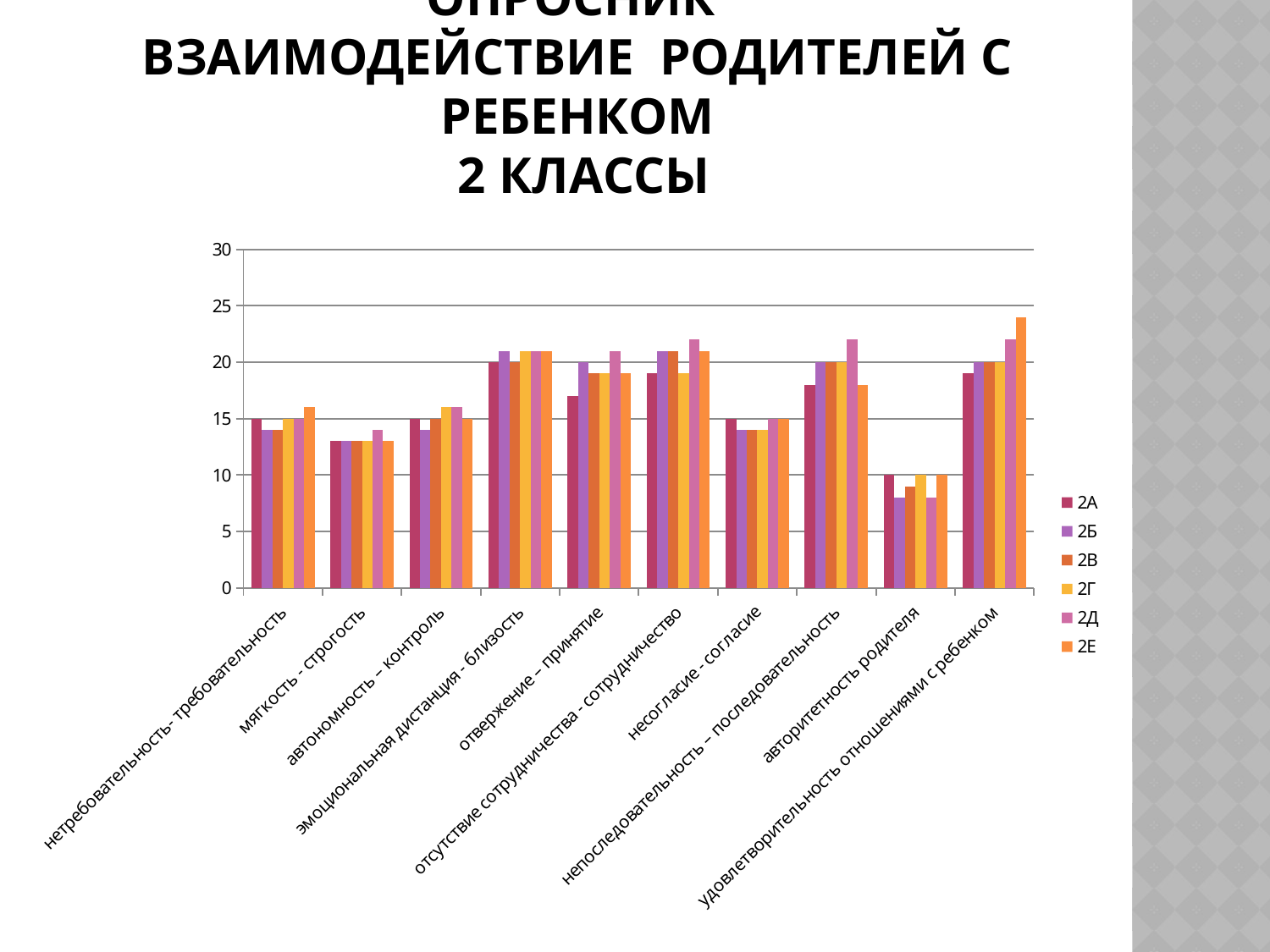
For 'отвержение – принятие', which is larger: the value for 2А or the value for 2Д? 2Д Is the value of 2Б for 'авторитетность родителя' greater or less than 10? less Is the value of 2А for 'мягкость - строгость' greater or less than 15? less How many series does the legend list? 6 Which category has the lowest values across all series? авторитетность родителя For 'непоследовательность – последовательность', which is larger: the value for 2Д or the value for 2Е? 2Д What kind of chart is shown on the slide? bar chart Is the value of 2Е for 'удовлетворительность отношениями с ребенком' greater or less than 20? greater Which series has the highest value for 'удовлетворительность отношениями с ребенком'? 2Е What is the value of 2А for 'авторитетность родителя'? 10 How many categories are shown along the x axis? 10